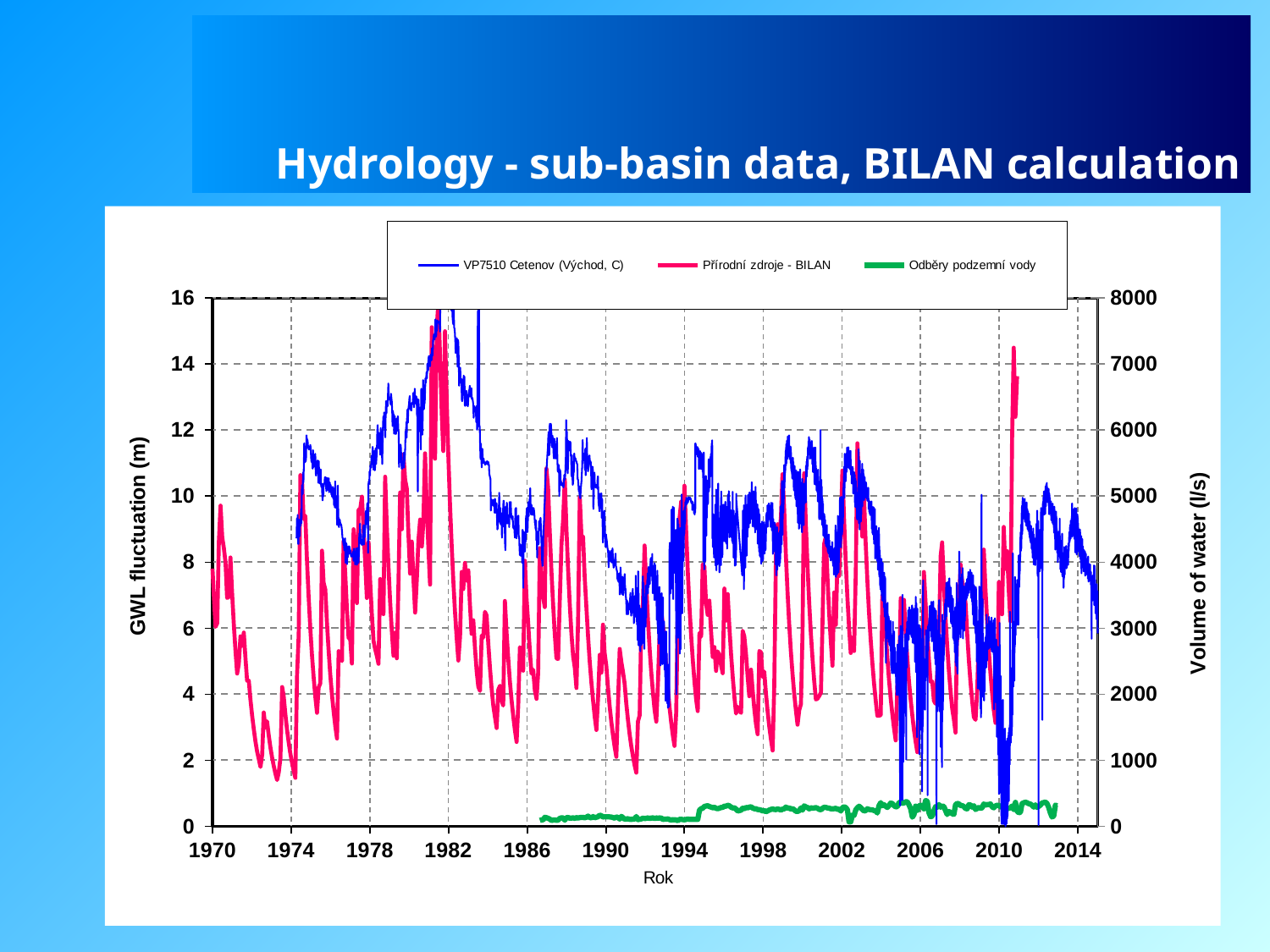
What is the title of the right vertical axis? Volume of water (l/s) How many series does the legend list? 3 Is the value of the green Odběry podzemní vody line around 2008 greater or less than 1000 on the right axis? less What kind of chart is shown on the slide? line chart Is the value of the pink Přírodní zdroje - BILAN line around 1973 greater or less than 2000 on the right axis? less How many year labels are shown on the x axis? 12 Does the blue VP7510 Cetenov (Východ, C) line generally rise or fall between 1970 and 1982? rise Is the value of the blue VP7510 Cetenov (Východ, C) line at the end of 2014 greater or less than 10 on the left axis? less What is the title of the left vertical axis? GWL fluctuation (m) Does the blue VP7510 Cetenov (Východ, C) line generally rise or fall between 2000 and 2010? fall Around the year 2000, which line is higher on the chart: the pink Přírodní zdroje - BILAN line or the green Odběry podzemní vody line? Přírodní zdroje - BILAN